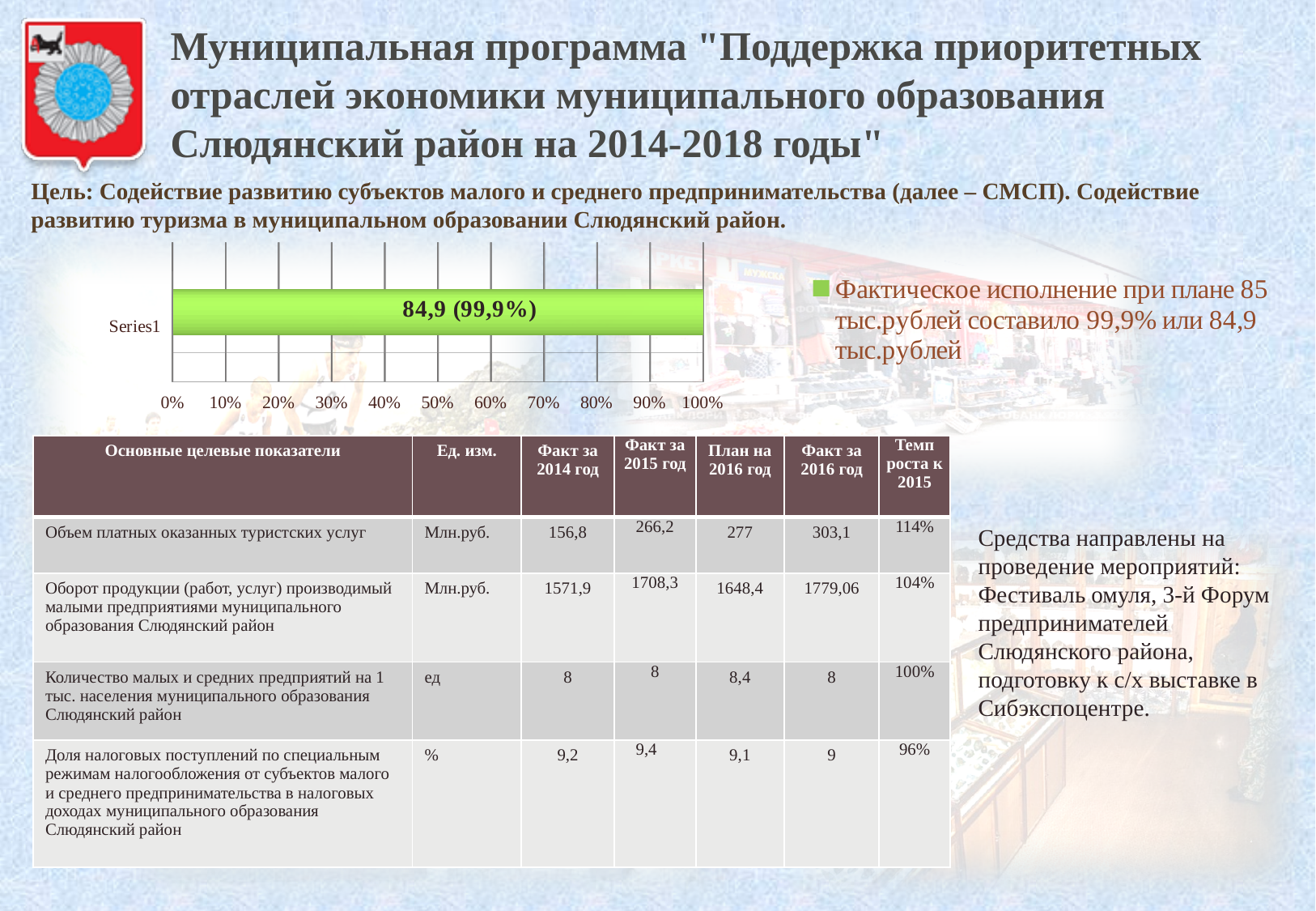
What data label is printed on the bar in the chart? 84,9 (99,9%) What kind of chart is shown on the slide? bar chart What is the category label shown on the y axis of the chart? Series1 Is the bar in the chart greater or less than 50% on the x axis? greater Is the bar in the chart greater or less than 90% on the x axis? greater How many series does the chart's legend list? 1 How many bars are plotted in the chart? 1 What is the highest tick value shown on the chart's x axis? 100%